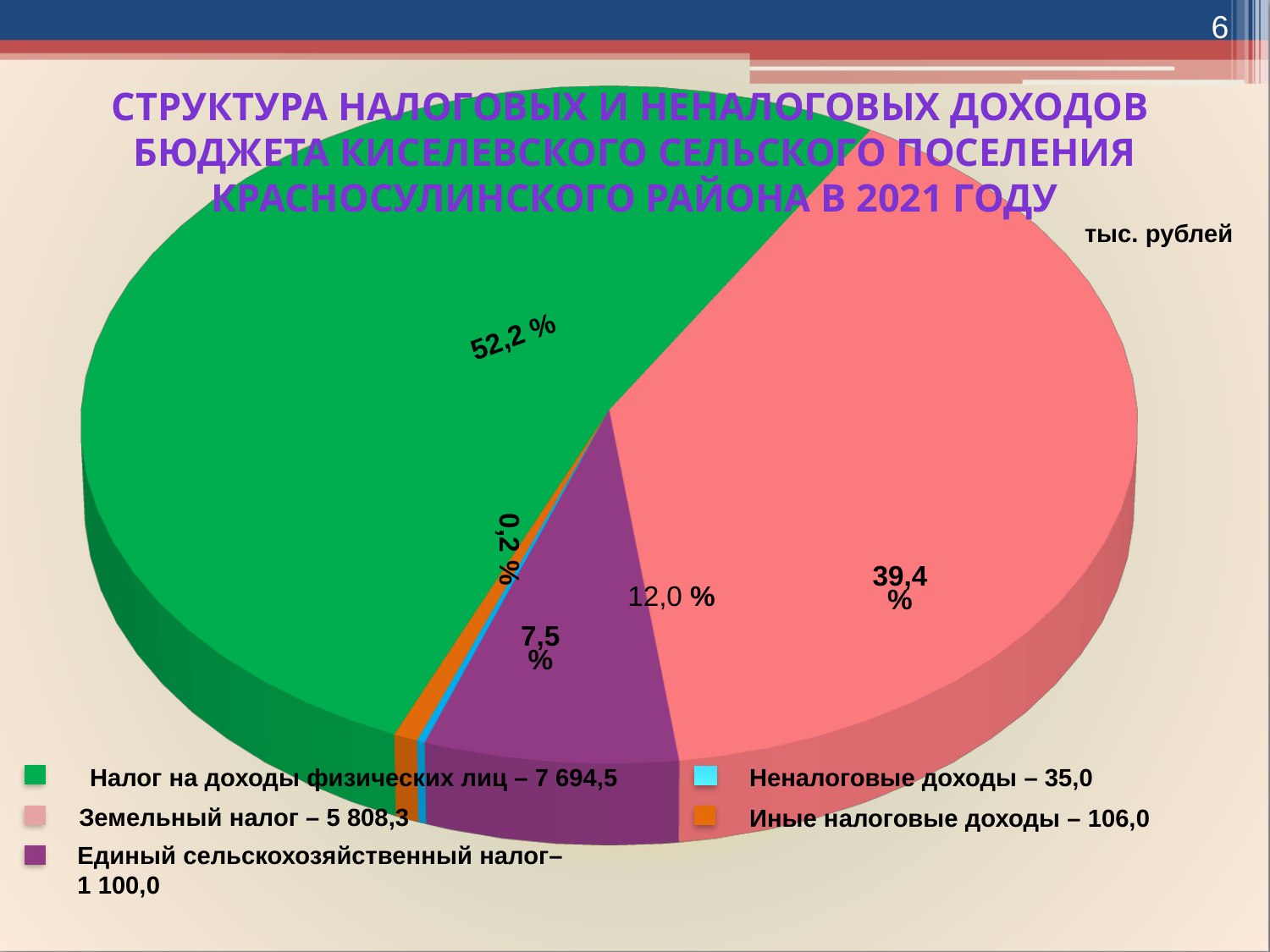
Which category has the largest share of the pie? Налог на доходы физических лиц What is the value for Земельный налог? 5 808,3 What kind of chart is shown on the slide? pie chart What is the value for Единый сельскохозяйственный налог? 1 100,0 In what units are the values on the chart given? тыс. рублей How many categories does the pie chart show? 5 What is the value for Неналоговые доходы? 35,0 What is the value for Налог на доходы физических лиц? 7 694,5 What share of the pie does Земельный налог represent? 39,4 % What is the difference between the values for Налог на доходы физических лиц and Земельный налог? 1 886,2 Which category has the smallest value? Неналоговые доходы What is the value for Иные налоговые доходы? 106,0